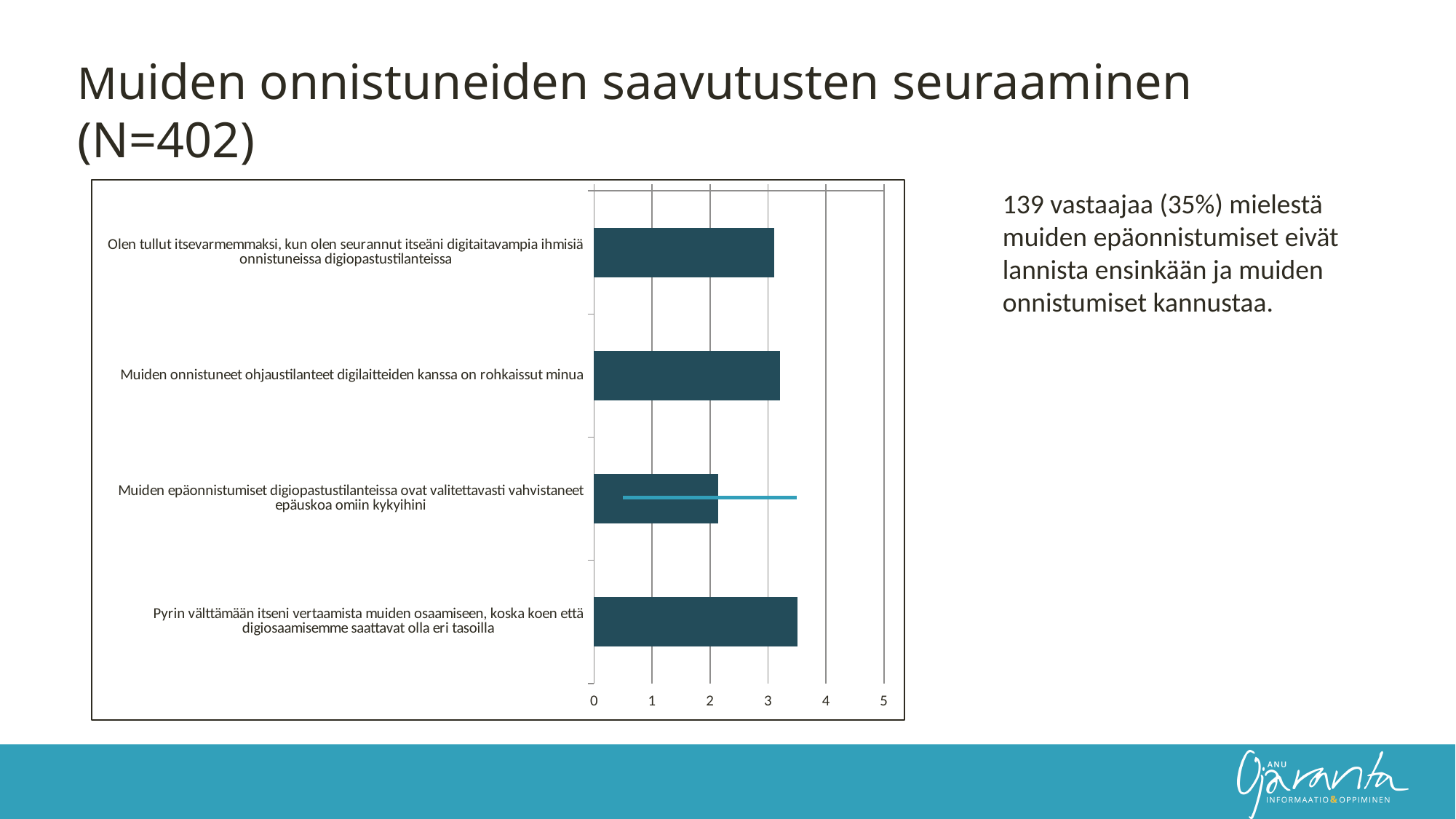
Which has the larger value: "Pyrin välttämään itseni vertaamista muiden osaamiseen, koska koen että digiosaamisemme saattavat olla eri tasoilla" or "Olen tullut itsevarmemmaksi, kun olen seurannut itseäni digitaitavampia ihmisiä onnistuneissa digiopastustilanteissa"? Pyrin välttämään itseni vertaamista muiden osaamiseen, koska koen että digiosaamisemme saattavat olla eri tasoilla What kind of chart is shown on the slide? bar chart Is the value for "Muiden epäonnistumiset digiopastustilanteissa ovat valitettavasti vahvistaneet epäuskoa omiin kykyihini" greater or less than 3? less Which statement has the lowest value in the chart? Muiden epäonnistumiset digiopastustilanteissa ovat valitettavasti vahvistaneet epäuskoa omiin kykyihini Which statement has the highest value in the chart? Pyrin välttämään itseni vertaamista muiden osaamiseen, koska koen että digiosaamisemme saattavat olla eri tasoilla Is the value for "Olen tullut itsevarmemmaksi, kun olen seurannut itseäni digitaitavampia ihmisiä onnistuneissa digiopastustilanteissa" greater or less than 4? less Which has the larger value: "Muiden onnistuneet ohjaustilanteet digilaitteiden kanssa on rohkaissut minua" or "Muiden epäonnistumiset digiopastustilanteissa ovat valitettavasti vahvistaneet epäuskoa omiin kykyihini"? Muiden onnistuneet ohjaustilanteet digilaitteiden kanssa on rohkaissut minua Is the value for "Muiden onnistuneet ohjaustilanteet digilaitteiden kanssa on rohkaissut minua" greater or less than 2? greater What is the maximum value shown on the chart's horizontal axis? 5 How many categories (statements) are plotted in the chart? 4 What is the title of the slide containing the chart? Muiden onnistuneiden saavutusten seuraaminen (N=402)